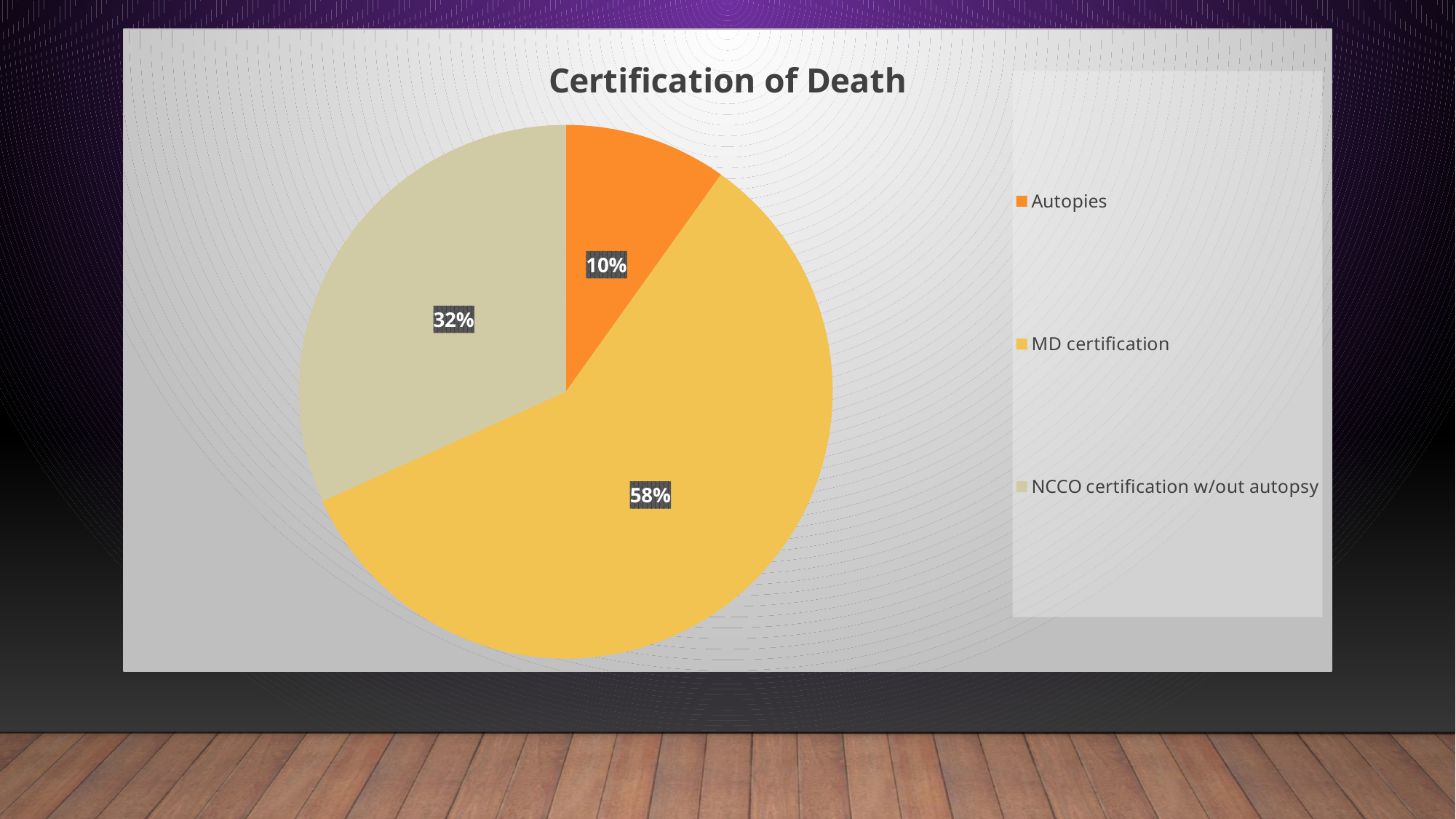
Which category has the smallest slice of the pie? Autopies What colour is the slice for Autopies? orange What is the difference in percentage points between NCCO certification w/out autopsy and Autopies? 22 What share of the pie is NCCO certification w/out autopsy? 32% What share of the pie is Autopies? 10% Which is larger, the slice for Autopies or the slice for NCCO certification w/out autopsy? NCCO certification w/out autopsy What type of chart is shown on the slide? pie chart Which category has the largest slice of the pie? MD certification What is the difference in percentage points between MD certification and NCCO certification w/out autopsy? 26 What is the title of the chart? Certification of Death What share of the pie is MD certification? 58% How many categories does the pie chart have? 3